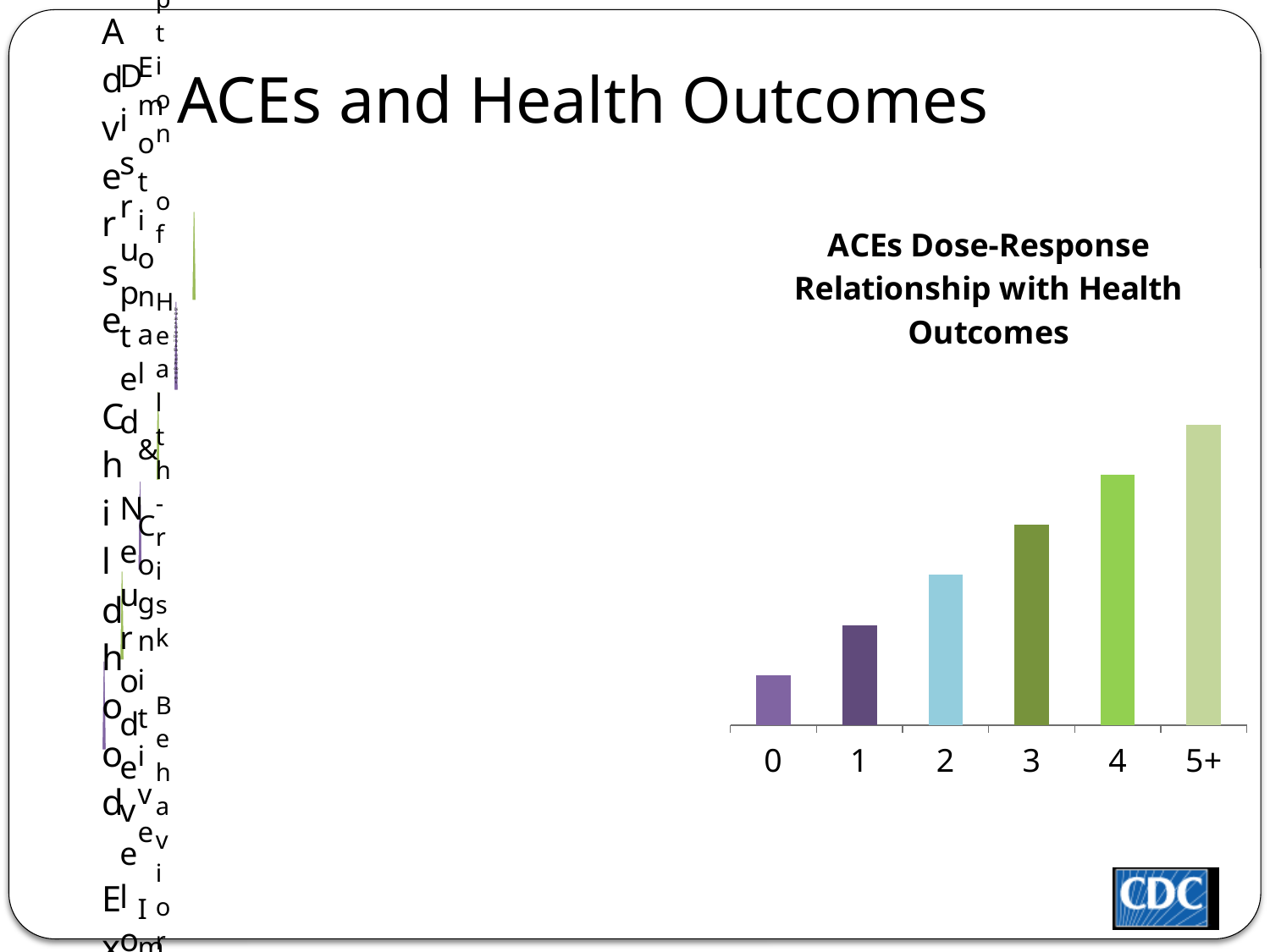
What is the title of the bar chart on the right side of the slide? ACEs Dose-Response Relationship with Health Outcomes In the chart titled "ACEs Dose-Response Relationship with Health Outcomes", which category has the shortest bar? 0 In the chart titled "ACEs Dose-Response Relationship with Health Outcomes", which bar is taller, the one for 1 or the one for 3? 3 In the chart titled "ACEs Dose-Response Relationship with Health Outcomes", do the bar heights rise or fall as the number of ACEs increases from 0 to 5+? rise In the chart titled "ACEs Dose-Response Relationship with Health Outcomes", which bar is taller, the one for 2 or the one for 4? 4 In the chart titled "ACEs Dose-Response Relationship with Health Outcomes", how many categories are plotted on the x axis? 6 In the chart titled "ACEs Dose-Response Relationship with Health Outcomes", what is the label of the last category on the x axis? 5+ In the chart titled "ACEs Dose-Response Relationship with Health Outcomes", which category has the tallest bar? 5+ In the chart titled "ACEs Dose-Response Relationship with Health Outcomes", what kind of chart is shown? bar chart